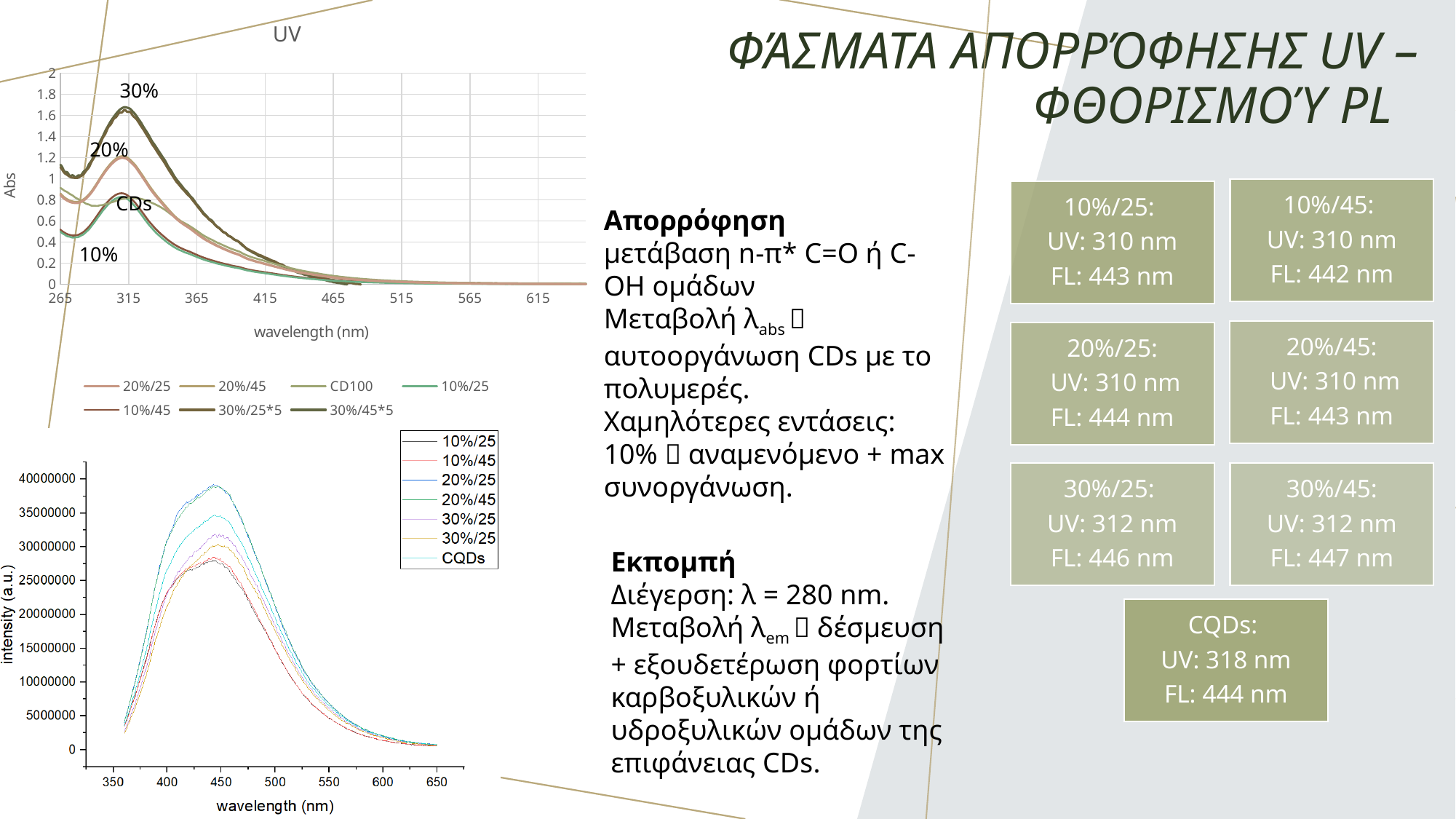
What is the label on the y axis of the top-left "UV" chart? Abs What kind of chart is the top-left chart titled "UV"? line chart In the top-left "UV" chart, is the peak absorbance of the curves labelled 30% greater or less than 1.4? greater What kind of chart is the bottom-left chart with the intensity (a.u.) axis? line chart In the top-left "UV" chart, which has the higher peak absorbance: the 20% curve or the 10% curve? 20% In the top-left "UV" chart, is the peak absorbance of the curve labelled 10% greater or less than 1? less In the top-left "UV" chart, how many series does the legend list? 7 In the bottom-left intensity chart, how many series does the legend list? 7 In the top-left "UV" chart, is the peak absorbance of the curve labelled 20% greater or less than 1? greater In the bottom-left intensity chart, do the intensity values rise or fall as wavelength increases from 450 nm to 650 nm? fall In the top-left "UV" chart, which labelled group of curves (10%, 20%, 30%) reaches the highest absorbance? 30%